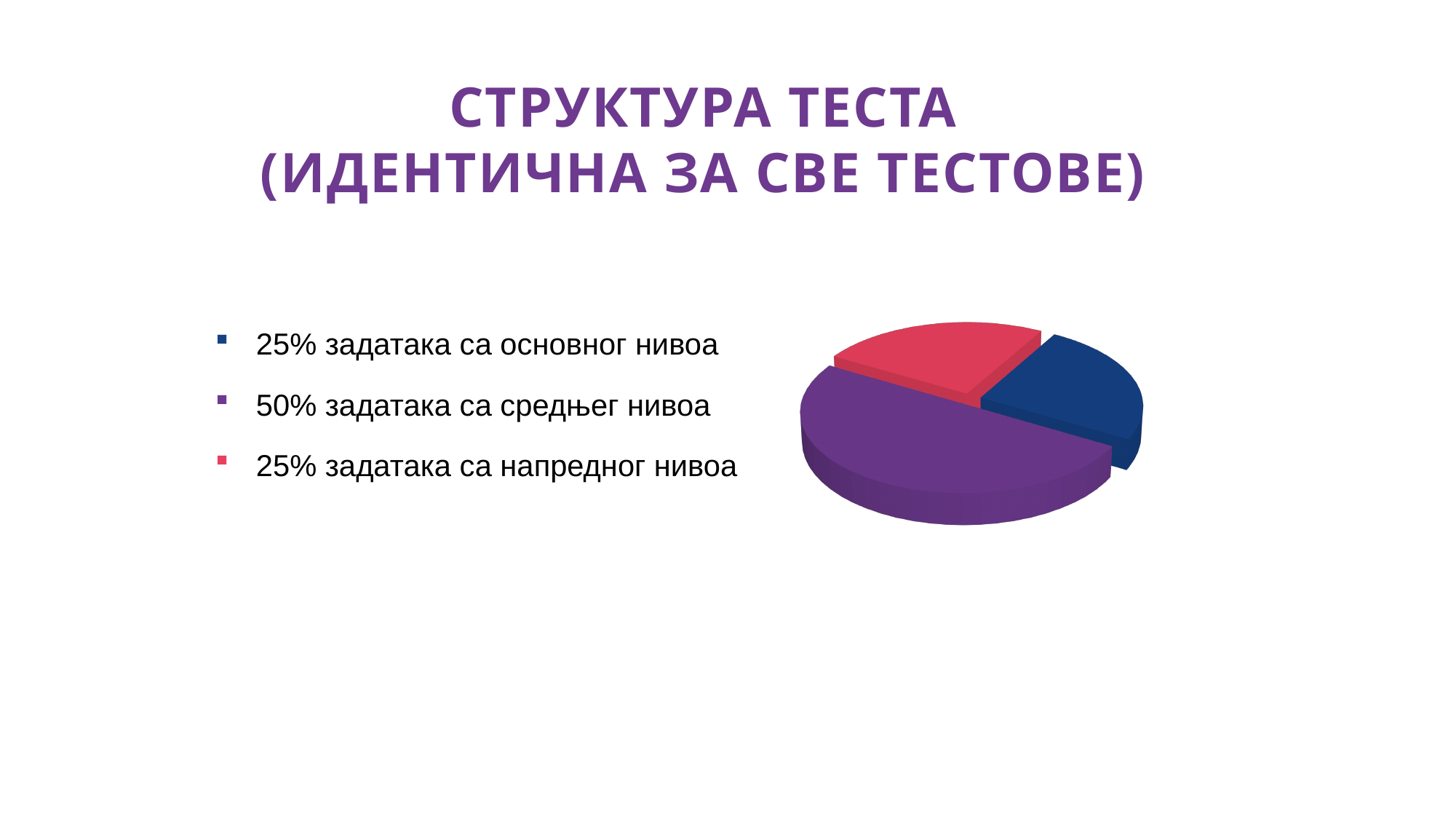
What is the combined share of basic-level and advanced-level tasks? 50% How many slices does the pie chart have? 3 What share of the tasks are from the intermediate level (средњег нивоа)? 50% What kind of chart is shown on the slide? Pie chart What share of the tasks are from the basic level (основног нивоа)? 25% What is the title of the slide containing the pie chart? СТРУКТУРА ТЕСТА (ИДЕНТИЧНА ЗА СВЕ ТЕСТОВЕ) What colour is the slice representing the intermediate level (средњег нивоа)? Purple What is the difference between the share of intermediate-level tasks and basic-level tasks? 25% Is the share of intermediate-level tasks greater or less than 40%? greater Which is larger: the share of intermediate-level tasks or the share of advanced-level tasks? Intermediate-level tasks Which level has the largest slice of the pie chart? Intermediate level (средњег нивоа) What share of the tasks are from the advanced level (напредног нивоа)? 25%